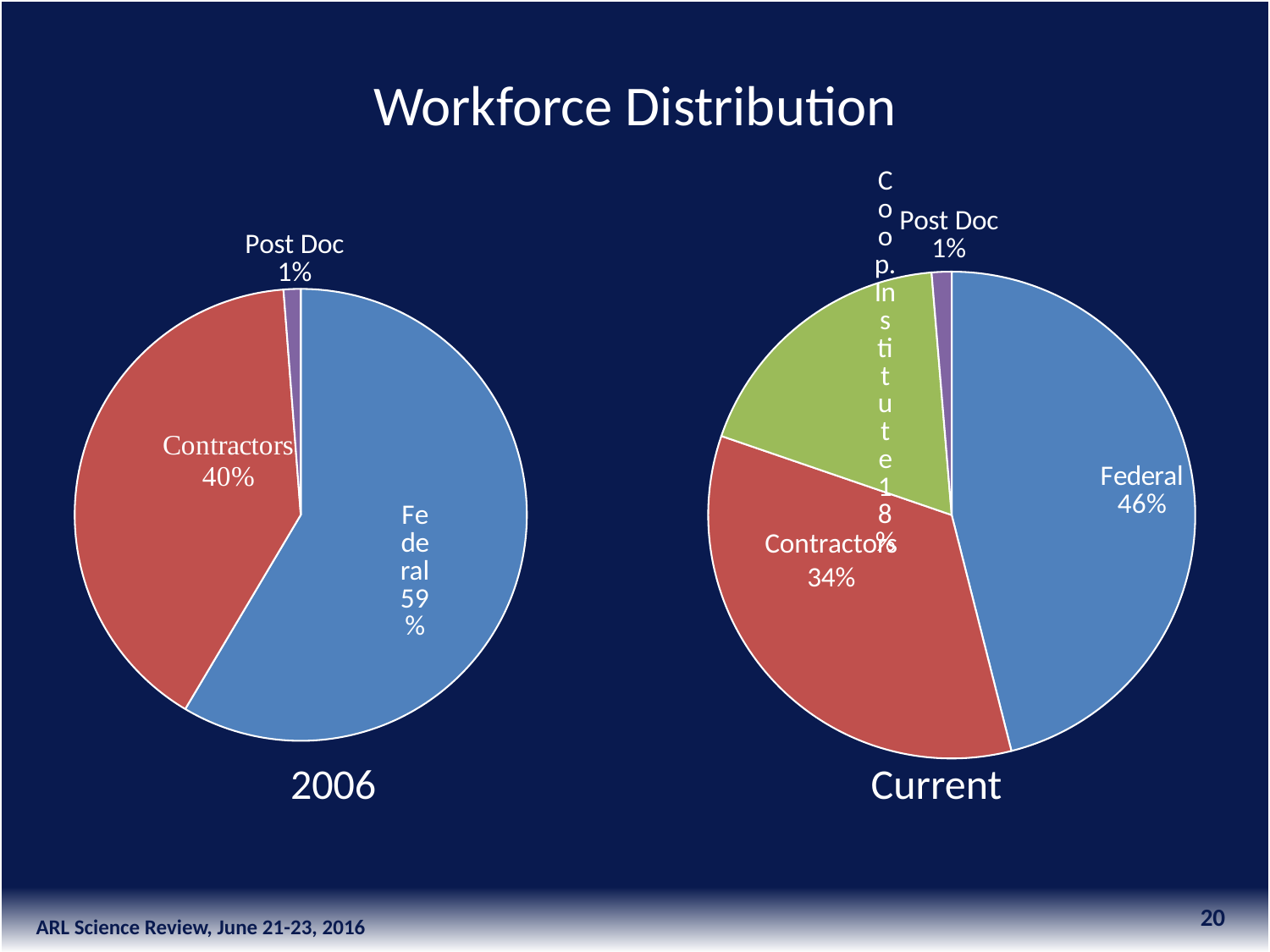
In the 2006 pie chart, what share of the workforce is Contractors? 40% In the 2006 pie chart, what share of the workforce is Federal? 59% What type of chart is used for the 2006 workforce distribution? Pie chart How many categories are shown in the 2006 pie chart? 3 In the Current pie chart, what share of the workforce is Contractors? 34% In the Current pie chart, which category has the smallest share? Post Doc In the Current pie chart, what share of the workforce is Federal? 46% In the 2006 pie chart, what is the difference between the Federal and Contractors shares? 19% Is the Federal share larger in the 2006 chart or the Current chart? 2006 In the Current pie chart, what share of the workforce is Post Doc? 1% How many categories are shown in the Current pie chart? 4 In the 2006 pie chart, which category has the largest share? Federal